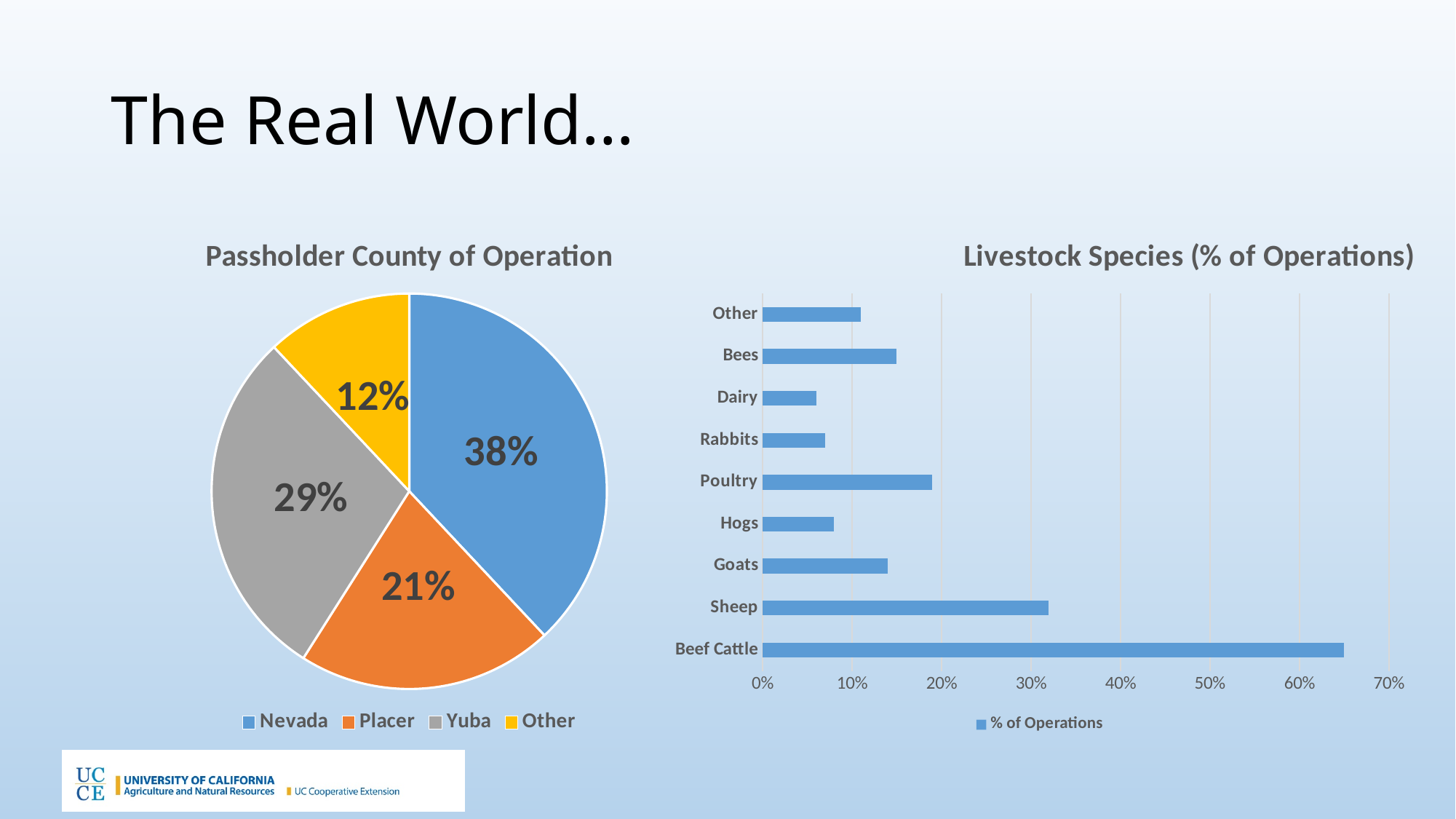
In the Passholder County of Operation pie chart, what share is Yuba? 29% In the Livestock Species (% of Operations) chart, which species has the highest value? Beef Cattle In the Passholder County of Operation pie chart, what share is Nevada? 38% In the Passholder County of Operation pie chart, which county has the largest share? Nevada How many species categories are shown in the Livestock Species (% of Operations) chart? 9 In the Livestock Species (% of Operations) chart, is the value for Beef Cattle greater or less than 60%? greater What kind of chart is the Livestock Species (% of Operations) chart? bar chart How many slices does the Passholder County of Operation pie chart have? 4 In the Passholder County of Operation pie chart, what is the difference between the Nevada and Placer shares? 17% In the Passholder County of Operation pie chart, which slice is the smallest? Other In the Livestock Species (% of Operations) chart, which is larger, Sheep or Goats? Sheep